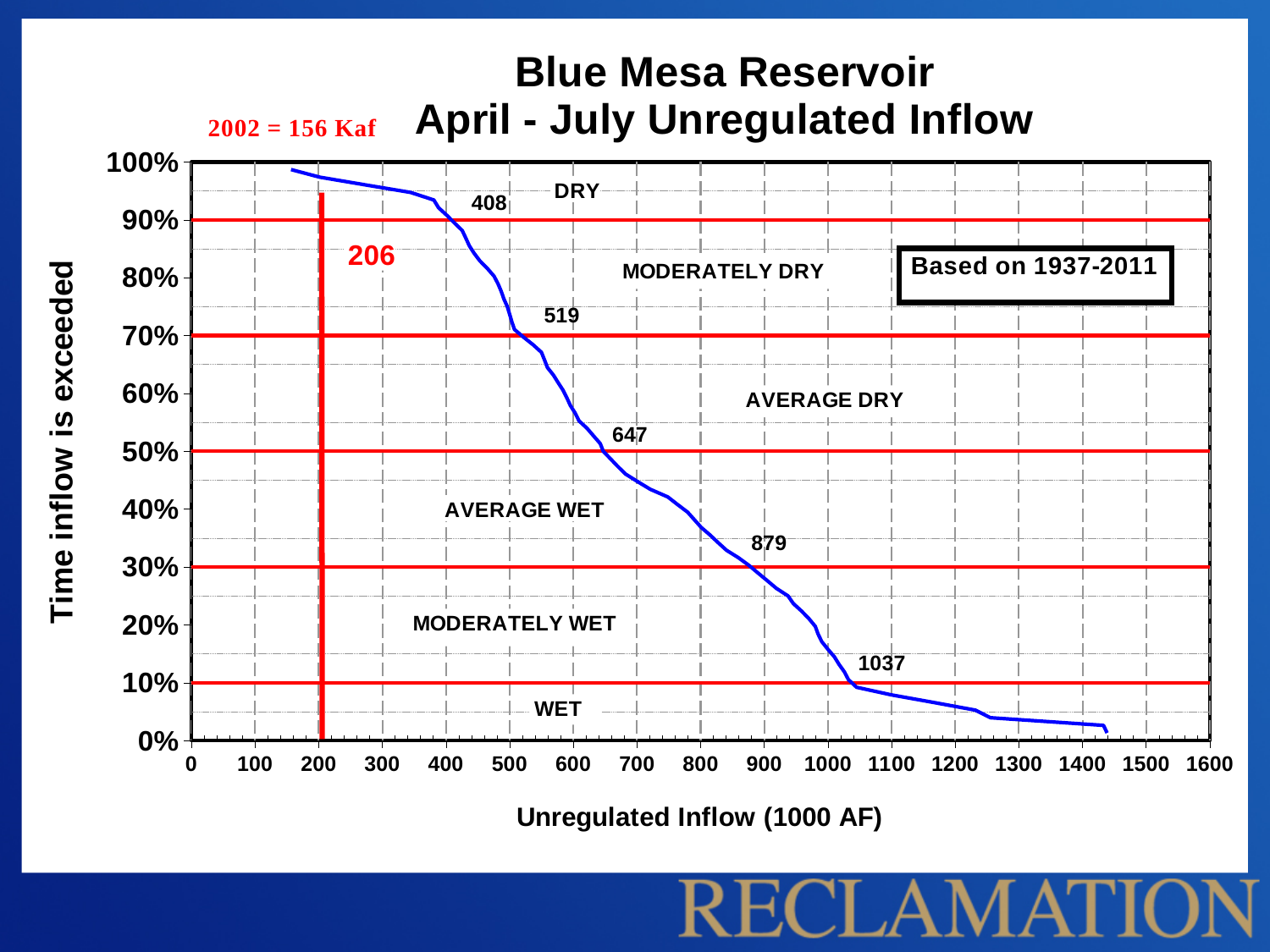
What kind of chart is shown on the slide? line chart What unregulated inflow value is labeled at the 10% exceedance level? 1037 What value is marked by the vertical red line on the chart? 206 What unregulated inflow value is labeled at the 50% exceedance level? 647 As unregulated inflow increases along the x axis, does the percentage of time the inflow is exceeded rise or fall? fall What unregulated inflow value is labeled at the 70% exceedance level? 519 What unregulated inflow value is labeled at the 90% exceedance level? 408 What is the difference between the inflow labeled at 50% exceedance and the inflow labeled at 70% exceedance? 128 Which is larger, the inflow labeled at 30% exceedance or the inflow labeled at 50% exceedance? 30% exceedance (879) What unregulated inflow value is labeled at the 30% exceedance level? 879 Is the inflow at the 20% exceedance level greater or less than 1000? less What is the difference between the inflow labeled at 10% exceedance and the inflow labeled at 30% exceedance? 158